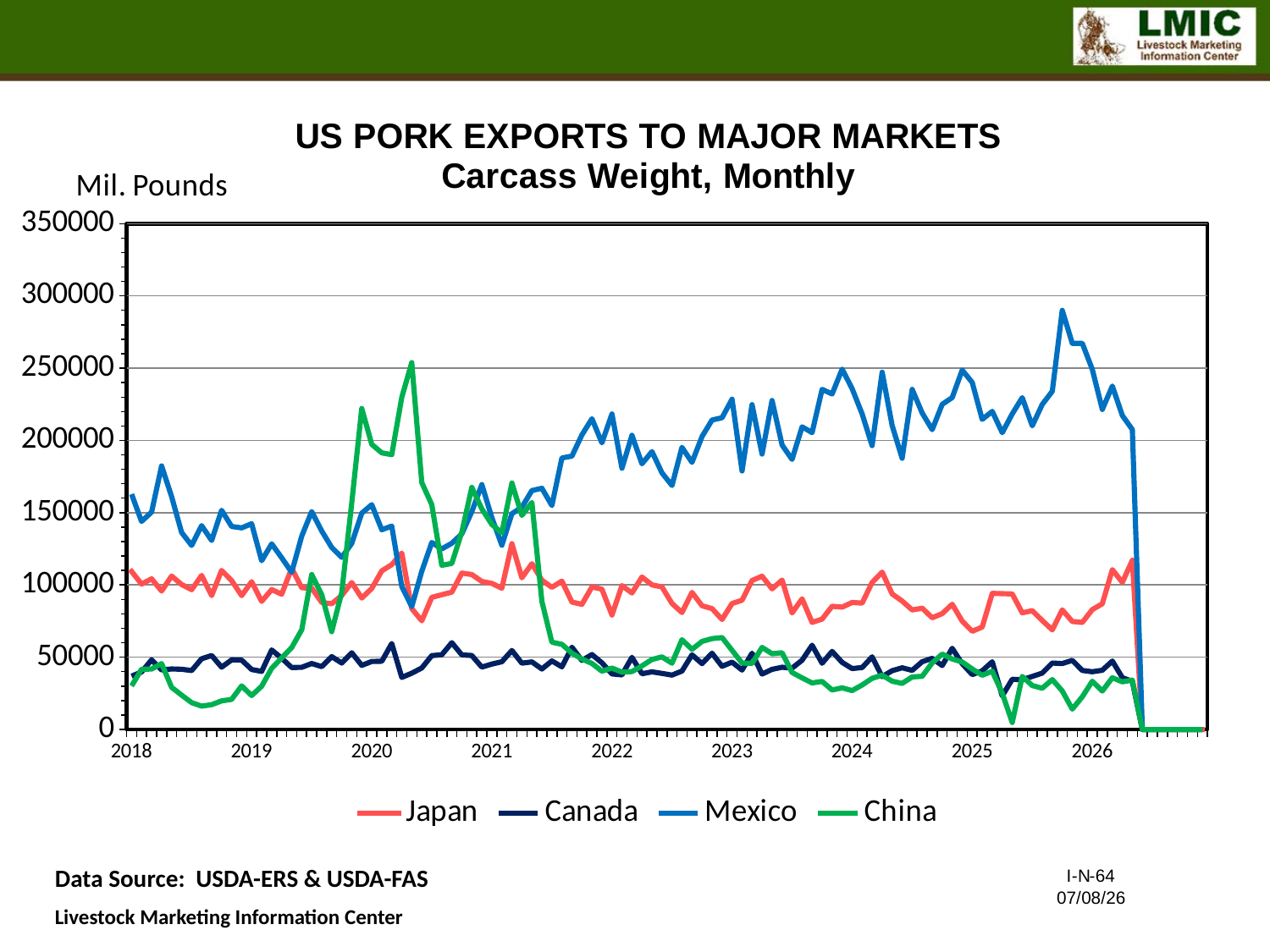
What unit is shown on the y axis of the chart? Mil. Pounds In 2024, which series has the larger values, Mexico or Japan? Mexico What is the title of the chart? US PORK EXPORTS TO MAJOR MARKETS Carcass Weight, Monthly How many series does the legend list? 4 Is the peak value for China in 2020 greater or less than 200000? greater Is the peak value for Mexico in late 2025 greater or less than 250000? greater Overall, do the values for Mexico rise or fall from 2018 to 2025? rise What kind of chart is shown on the slide? line chart Which series reaches the highest value anywhere on the chart? Mexico Is the value for Japan at the start of 2018 greater or less than 50000? greater In 2018, which series has the larger values, Japan or Canada? Japan